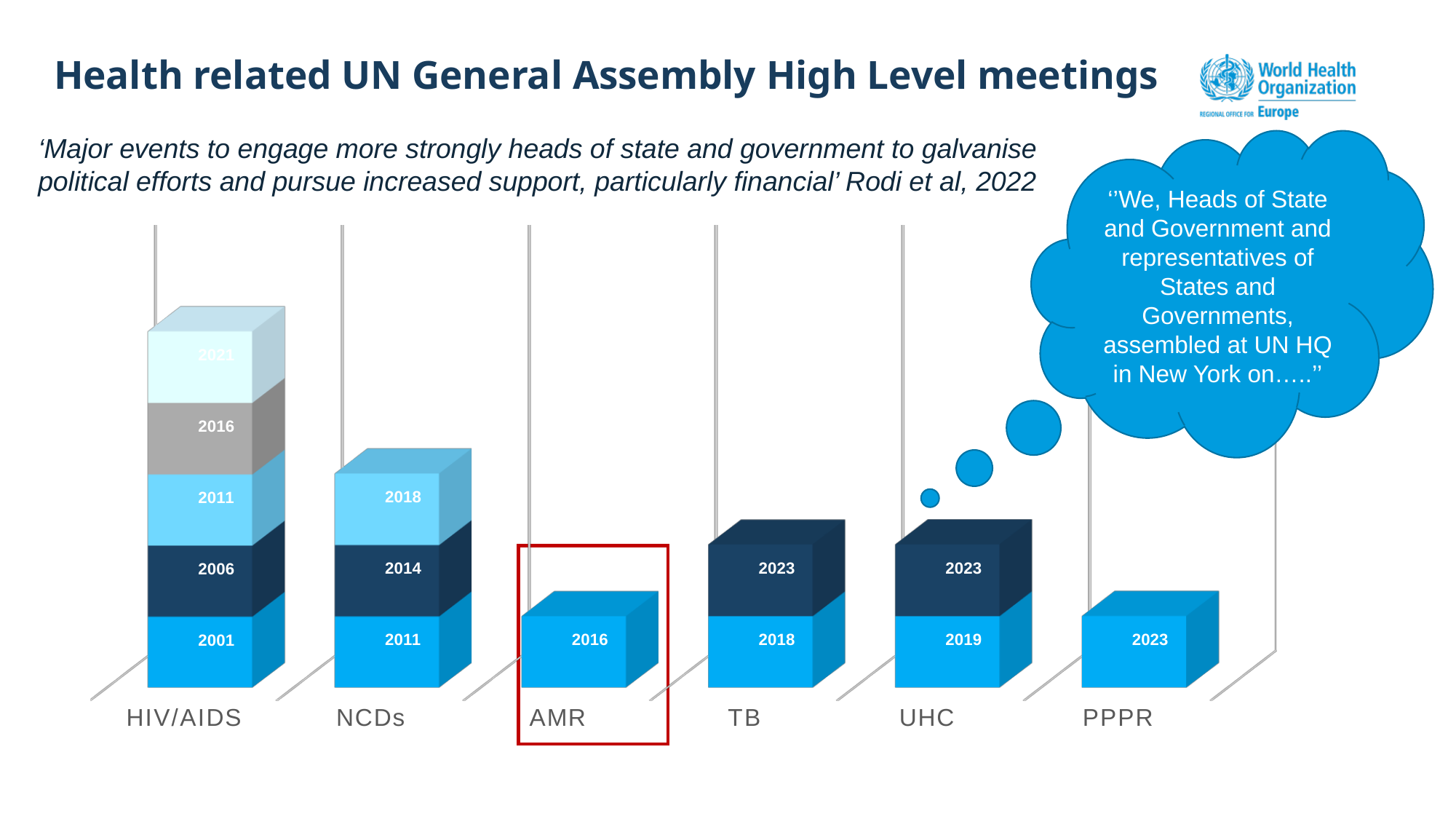
Which years are labelled on the blocks of the NCDs bar? 2011, 2014, 2018 Which bar has more stacked blocks, NCDs or TB? NCDs What kind of chart is shown on the slide? Stacked bar chart What year is labelled on the PPPR bar? 2023 How many blocks are stacked in the HIV/AIDS bar? 5 How many categories are shown along the x axis of the chart? 6 Which years are labelled on the TB bar? 2018, 2023 Which category has the tallest bar (the most stacked blocks)? HIV/AIDS What is the title of the slide containing the chart? Health related UN General Assembly High Level meetings Which category is outlined with a red box on the chart? AMR What year is labelled on the AMR bar? 2016 Which years are labelled on the UHC bar? 2019, 2023